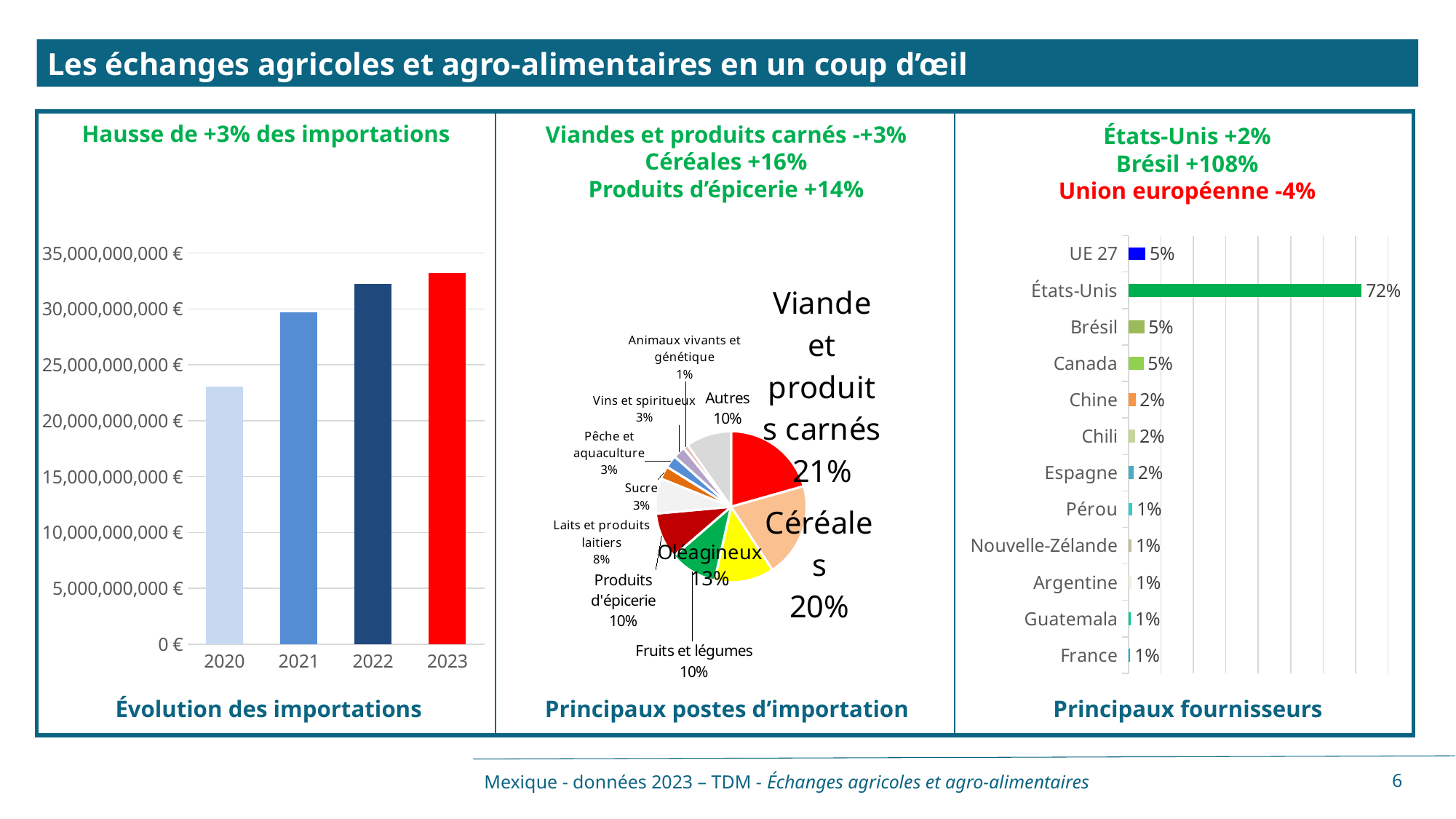
How many years are shown in the 'Évolution des importations' chart? 4 How many suppliers are listed in the 'Principaux fournisseurs' chart? 12 In the 'Évolution des importations' chart, which year has the highest value? 2023 In the 'Principaux fournisseurs' chart, what is the value for États-Unis? 72% In the 'Principaux postes d'importation' pie chart, which category has the smallest share? Animaux vivants et génétique In the 'Évolution des importations' chart, is the value for 2020 greater or less than 25,000,000,000 €? less In the 'Principaux fournisseurs' chart, what is the difference between États-Unis and Brésil? 67 percentage points In the 'Principaux postes d'importation' pie chart, what share does Céréales have? 20% In the 'Évolution des importations' chart, do the values rise or fall from 2020 to 2023? rise In the 'Principaux postes d'importation' pie chart, which category has the largest share? Viande et produits carnés In the 'Principaux postes d'importation' pie chart, what is the share of Laits et produits laitiers? 8% In the 'Évolution des importations' chart, is the value for 2022 greater or less than 30,000,000,000 €? greater